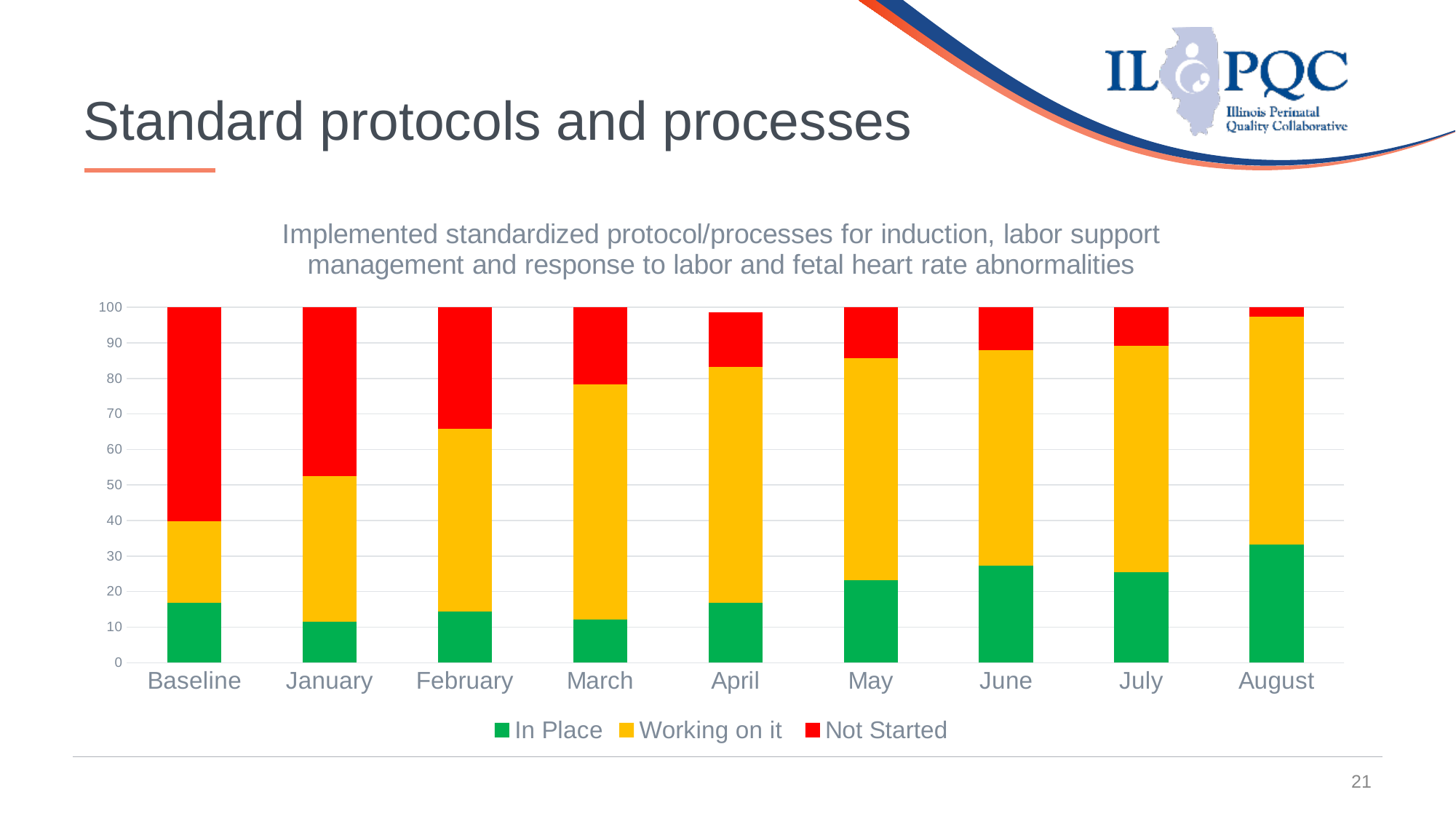
Which colour represents the 'Working on it' series in the chart? Yellow What kind of chart is shown on the slide? Stacked bar chart Which category has the smallest 'Not Started' segment? August Is the 'In Place' value for Baseline greater or less than 20? less Is the 'In Place' value for August greater or less than 30? greater Does the 'Not Started' segment rise or fall from Baseline to August? Fall Which category has the largest 'Not Started' segment? Baseline Which category has the largest 'In Place' segment? August How many categories are shown along the x axis of the chart? 9 Is the 'Not Started' value for Baseline greater or less than 50? greater Which is larger, the 'In Place' value for June or for January? June How many series does the chart's legend list? 3